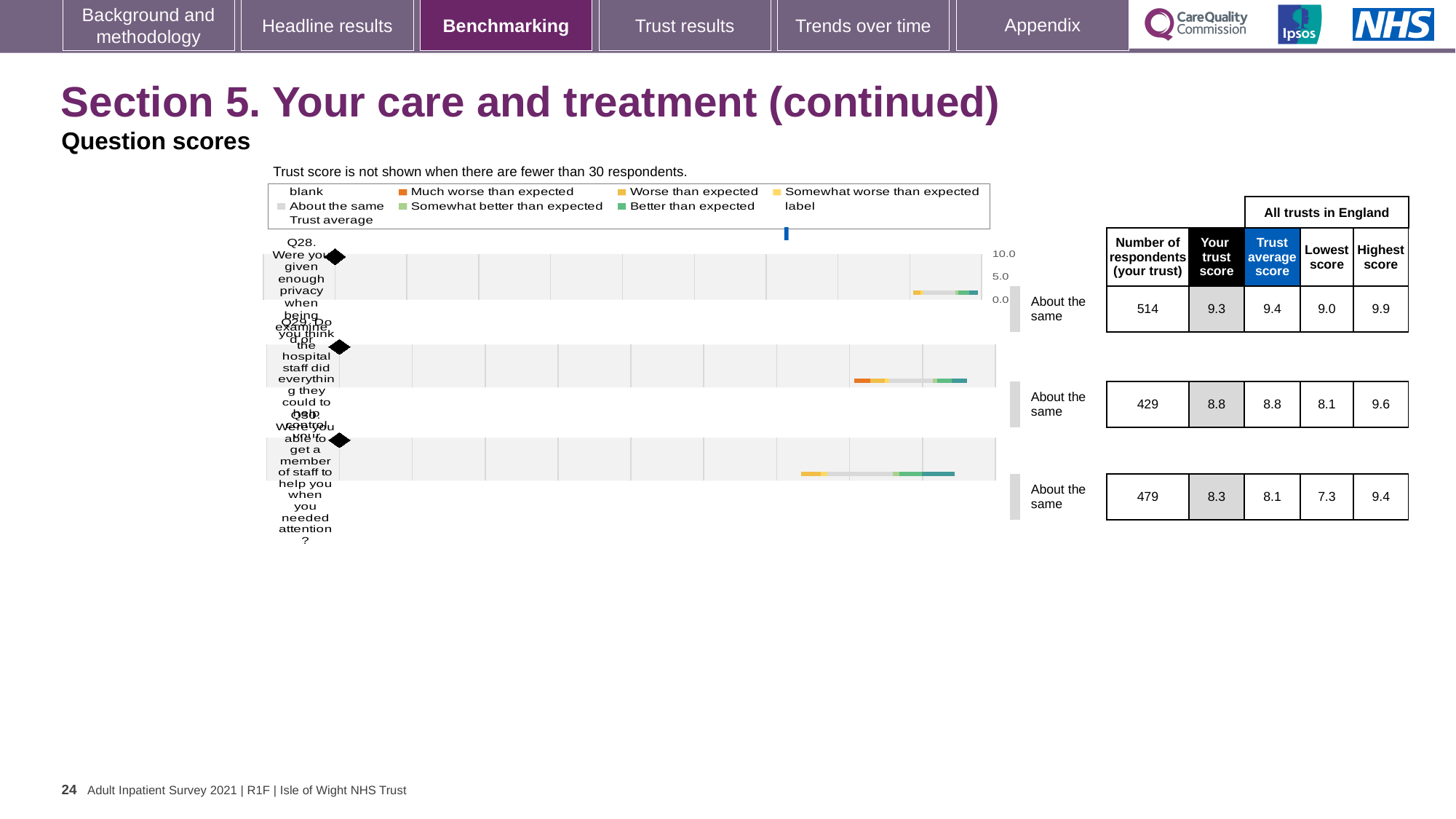
Which question has the highest 'Your trust score'? Q28 For Q29, what is the difference between the highest score and the lowest score? 1.5 Which question has the lowest 'Your trust score'? Q30 For Q28, what is the difference between the trust average score and your trust score? 0.1 What is the highest score across all trusts in England for Q30? 9.4 How many questions (Q28, Q29, Q30) are plotted on the slide? 3 What is the maximum value shown on the chart's score axis? 10.0 What kind of chart is used to show the question scores on this slide? bar chart Is the trust average marker for Q28 greater or less than 5.0 on the axis? greater What is the 'Your trust score' value for Q28? 9.3 For Q30, which is larger: your trust score or the trust average score? Your trust score How many respondents does the table show for Q29? 429